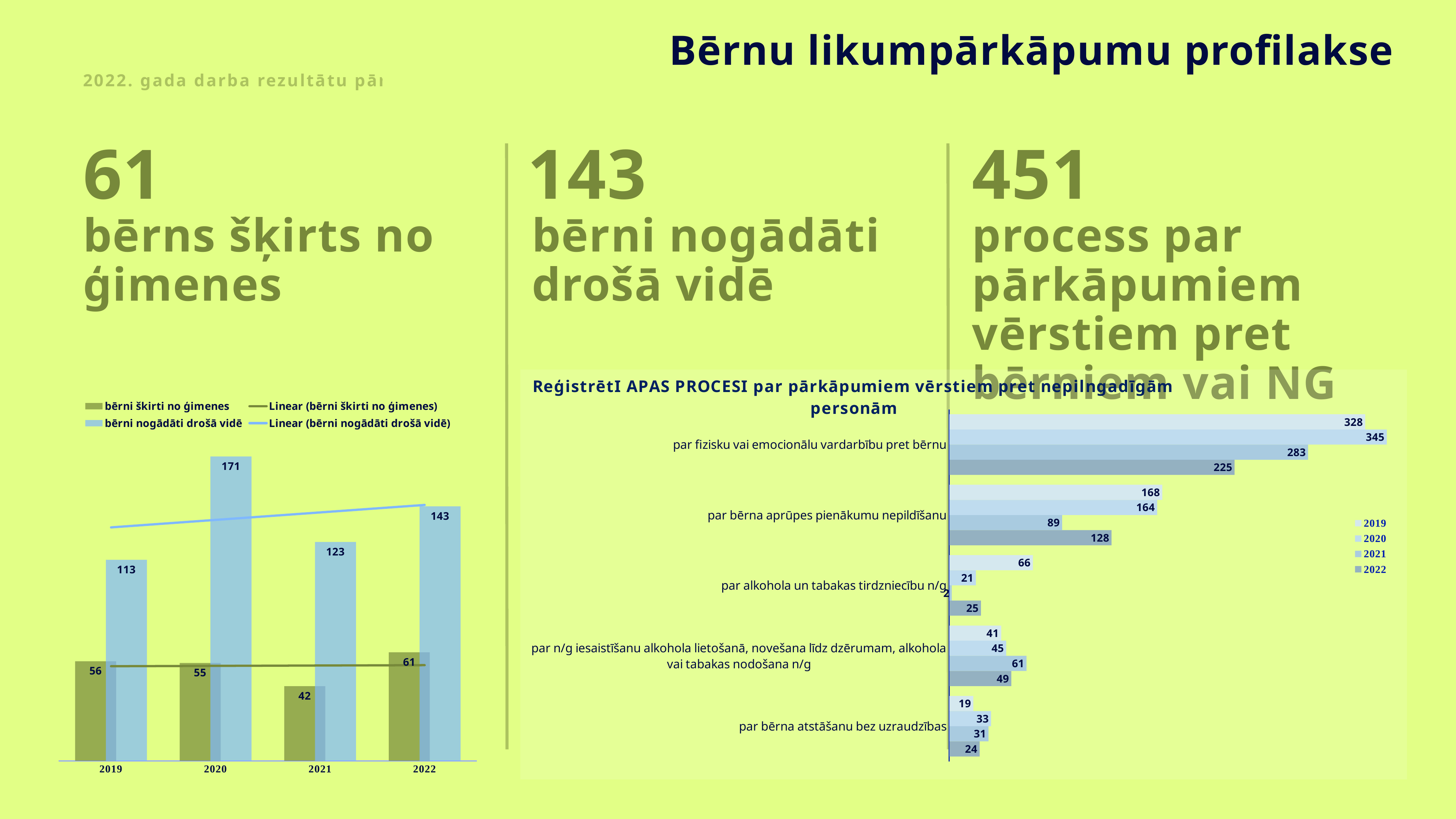
In the chart titled 'Reģistrēti APAS PROCESI par pārkāpumiem vērstiem pret nepilngadīgām personām', what is the 2020 value for 'par fizisku vai emocionālu vardarbību pret bērnu'? 345 In the chart titled 'Reģistrēti APAS PROCESI par pārkāpumiem vērstiem pret nepilngadīgām personām', which is larger for 'par bērna atstāšanu bez uzraudzības': the 2020 value or the 2022 value? 2020 In the left chart, what is the difference between 'bērni nogādāti drošā vidē' and 'bērni šķirti no ģimenes' in 2022? 82 In the left chart, what is the value for 'bērni šķirti no ģimenes' in 2021? 42 In the left chart, what is the value for 'bērni nogādāti drošā vidē' in 2020? 171 In the left chart, how many years are shown on the x axis? 4 In the left chart, how many entries does the legend list? 4 In the chart titled 'Reģistrēti APAS PROCESI par pārkāpumiem vērstiem pret nepilngadīgām personām', what is the 2022 value for 'par bērna aprūpes pienākumu nepildīšanu'? 128 In the left chart, which year has the lowest value for 'bērni šķirti no ģimenes'? 2021 What type of chart is the one titled 'Reģistrēti APAS PROCESI par pārkāpumiem vērstiem pret nepilngadīgām personām'? Bar chart In the chart titled 'Reģistrēti APAS PROCESI par pārkāpumiem vērstiem pret nepilngadīgām personām', what is the difference between the 2019 and 2021 values for 'par fizisku vai emocionālu vardarbību pret bērnu'? 45 In the left chart, which year has the highest value for 'bērni nogādāti drošā vidē'? 2020